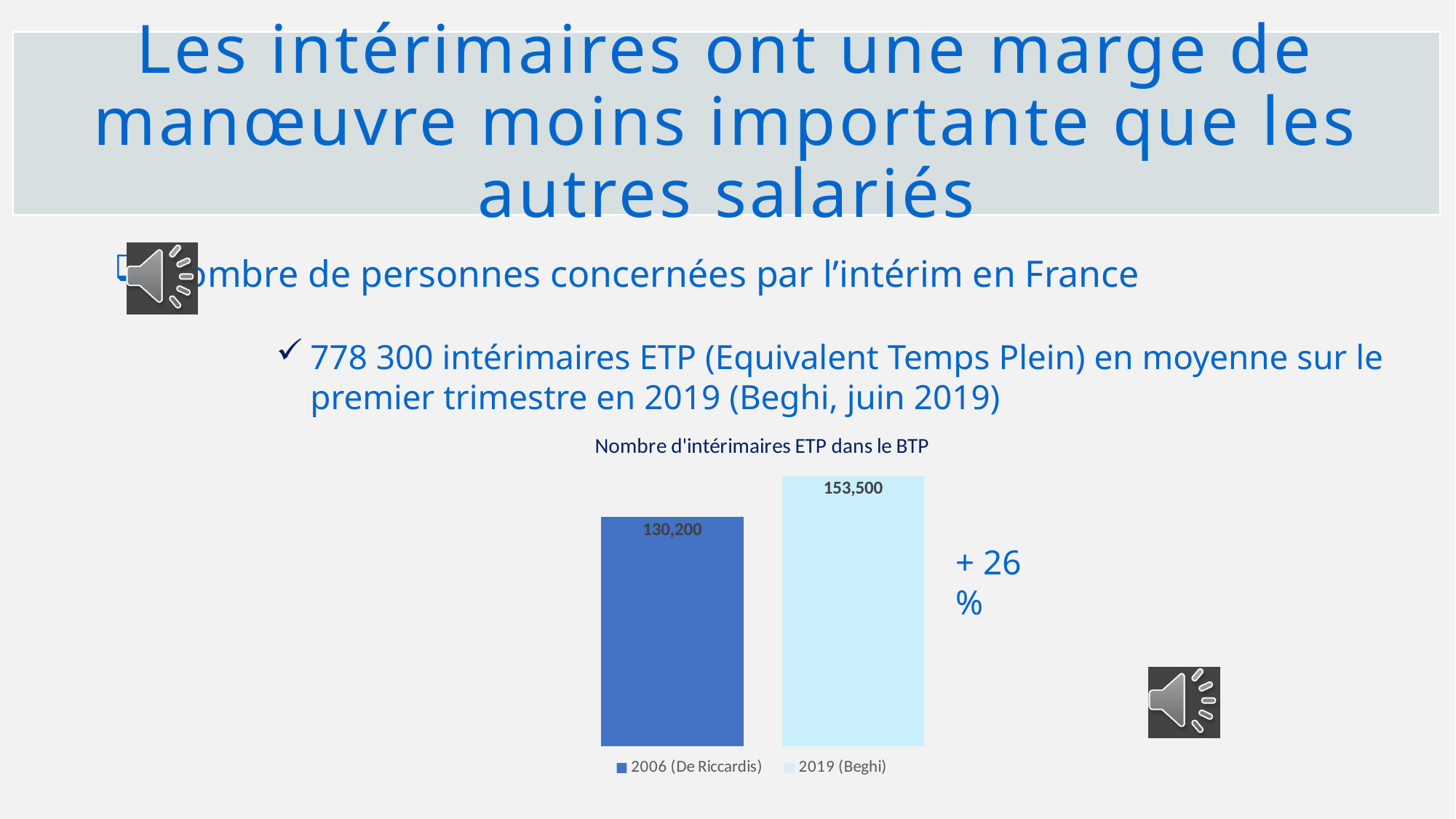
What percentage change is annotated next to the chart? + 26 % What kind of chart is shown on the slide? bar chart Do the values rise or fall from 2006 to 2019? rise How many series does the legend list? 2 What is the value for 2006 (De Riccardis) in the chart? 130,200 What is the title of the chart? Nombre d'intérimaires ETP dans le BTP Is the value for 2006 (De Riccardis) larger or smaller than the value for 2019 (Beghi)? smaller What is the difference between the 2019 (Beghi) value and the 2006 (De Riccardis) value? 23,300 How many bars are plotted in the chart? 2 What is the value for 2019 (Beghi) in the chart? 153,500 Which series has the lower value in the chart? 2006 (De Riccardis) Which series has the higher value, 2006 (De Riccardis) or 2019 (Beghi)? 2019 (Beghi)